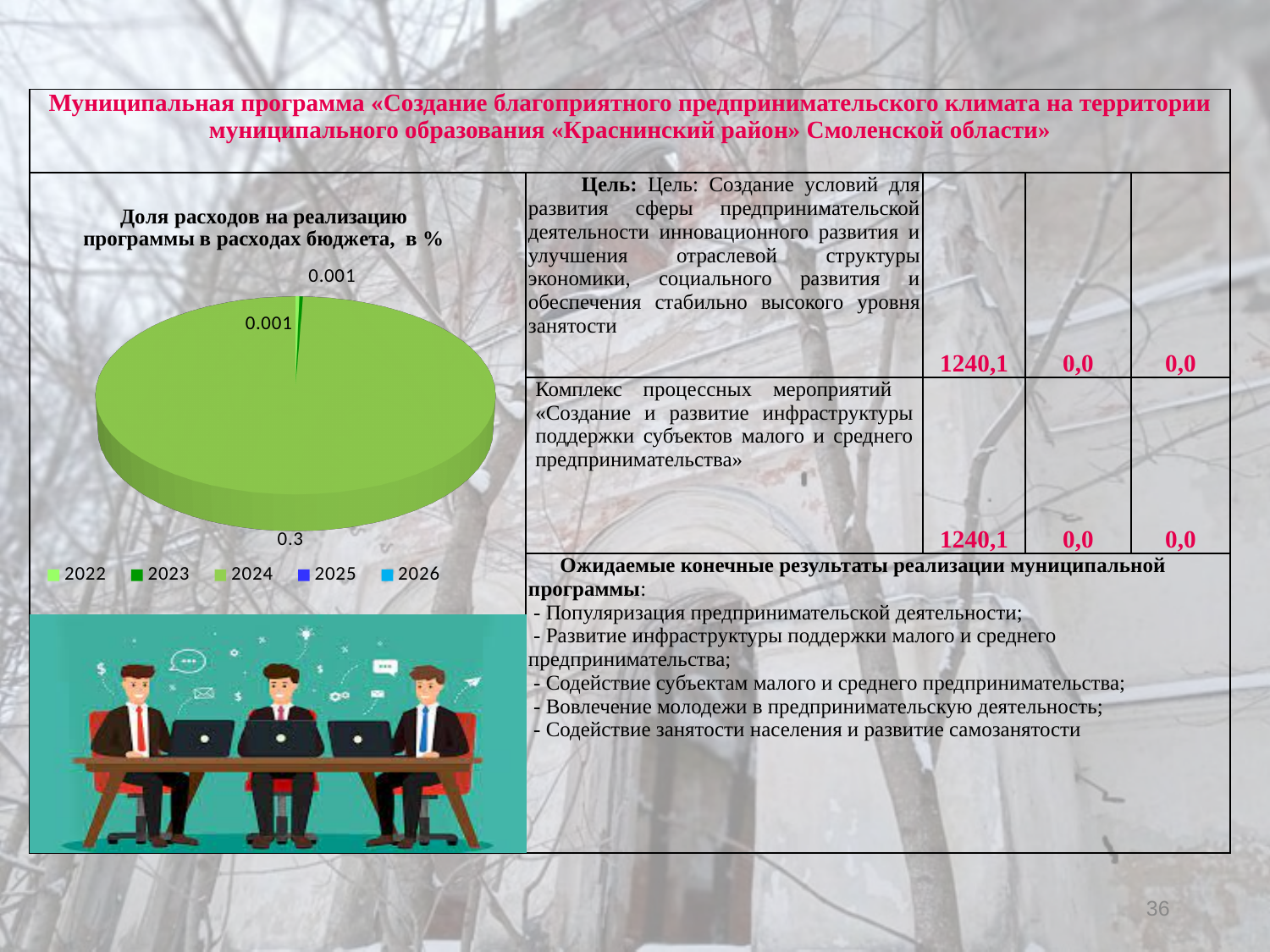
What kind of chart is shown on the slide? pie chart What is the title of the pie chart? Доля расходов на реализацию программы в расходах бюджета, в % How many data labels are printed on the pie chart? 3 What is the smallest value labelled on the pie chart? 0.001 Is the largest labelled value on the pie chart greater or less than 0.1? greater Which years are listed in the legend of the pie chart? 2022, 2023, 2024, 2025, 2026 What is the difference between the largest labelled value (0.3) and the smallest labelled value (0.001) on the pie chart? 0.299 What is the largest value labelled on the pie chart? 0.3 How many entries does the legend of the pie chart list? 5 Is the slice labelled 0.3 larger or smaller than the slice labelled 0.001? larger